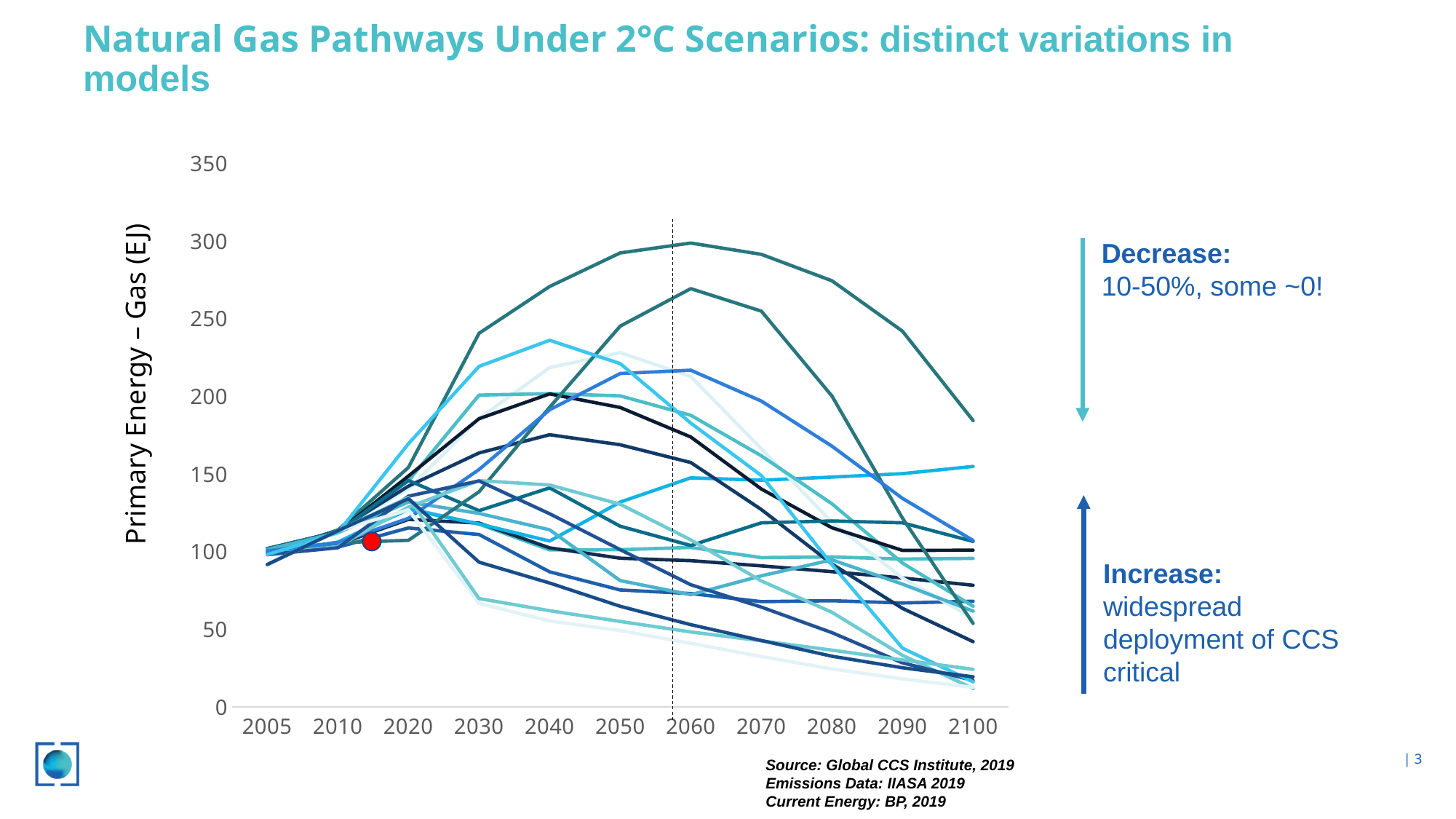
What is the label of the y-axis of the chart? Primary Energy – Gas (EJ) What kind of chart is shown on the slide? line chart Does the highest line in the chart rise or fall between 2060 and 2100? fall What is the highest value labelled on the y-axis of the chart? 350 Is the peak value reached by the highest line in the chart greater or less than 250? greater Is the lowest value among the lines in 2100 greater or less than 50? less What is the title of the slide containing the chart? Natural Gas Pathways Under 2°C Scenarios: distinct variations in models What is the last year shown on the x-axis of the chart? 2100 In 2005, are the values of the lines greater or less than 150? less How many year labels are shown on the x-axis of the chart? 11 In which year does the highest line in the chart reach its peak? 2060 What is the first year shown on the x-axis of the chart? 2005